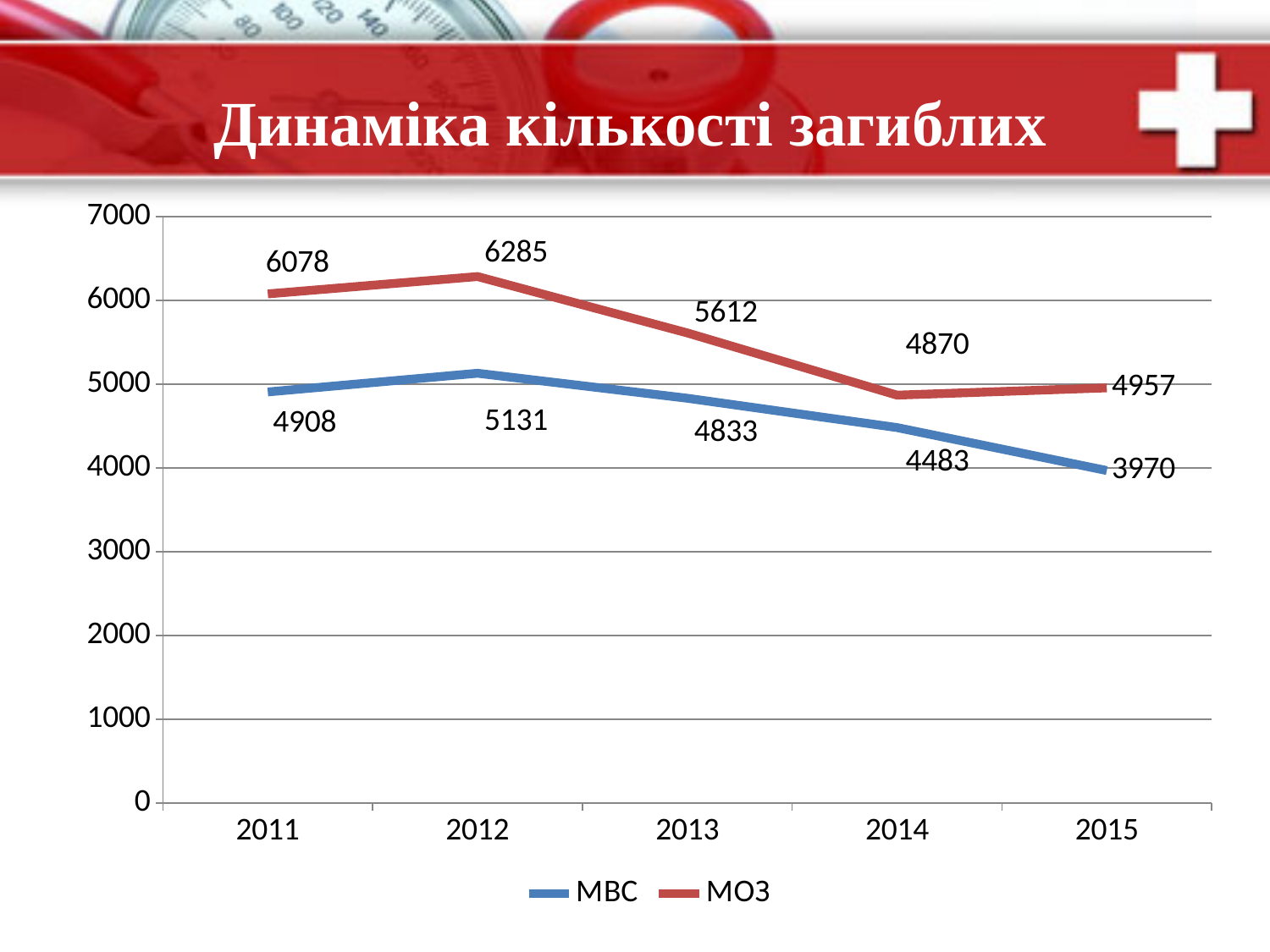
What is the value for МОЗ in 2012? 6285 How many series does the legend list? 2 What is the title of the chart? Динаміка кількості загиблих In which year is the МОЗ value highest? 2012 Does the МВС line rise or fall from 2012 to 2015? fall What is the value for МОЗ in 2015? 4957 How many years are shown on the x axis? 5 Which is larger in 2014: the МВС value or the МОЗ value? МОЗ In which year is the МВС value lowest? 2015 What is the value for МВС in 2013? 4833 What is the difference between the МОЗ and МВС values in 2011? 1170 What type of chart is shown on the slide? line chart